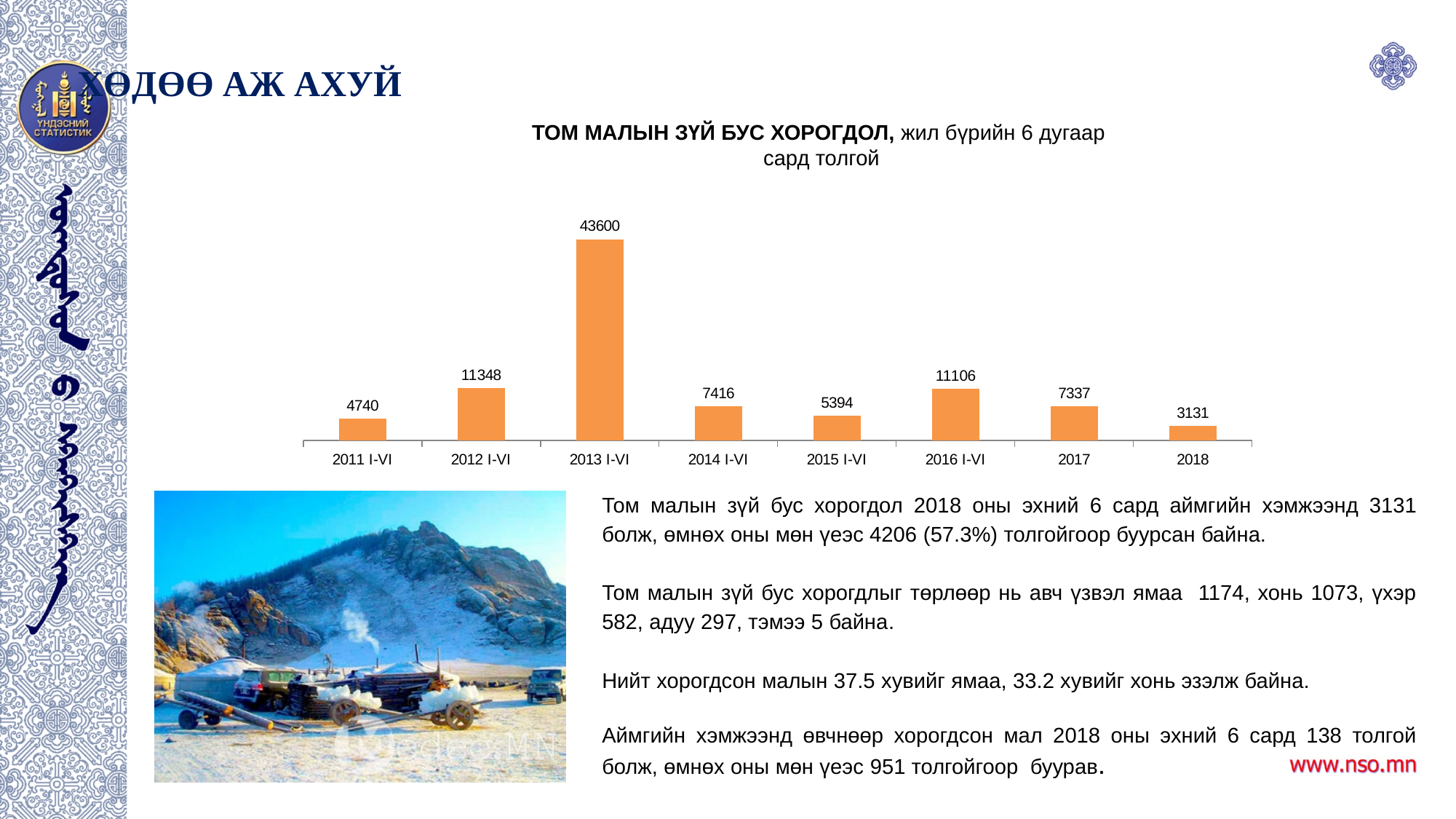
What colour are the bars in the chart? orange What kind of chart is shown on the slide? bar chart Which category has the highest value? 2013 I-VI What is the value for 2016 I-VI? 11106 How many categories are shown on the x axis? 8 What is the difference between the values for 2017 and 2018? 4206 Do the values rise or fall from 2016 I-VI to 2018? fall What is the value for 2013 I-VI? 43600 What is the difference between the values for 2012 I-VI and 2011 I-VI? 6608 What is the value for 2018? 3131 Which is larger, the value for 2014 I-VI or the value for 2015 I-VI? 2014 I-VI Which category has the lowest value? 2018